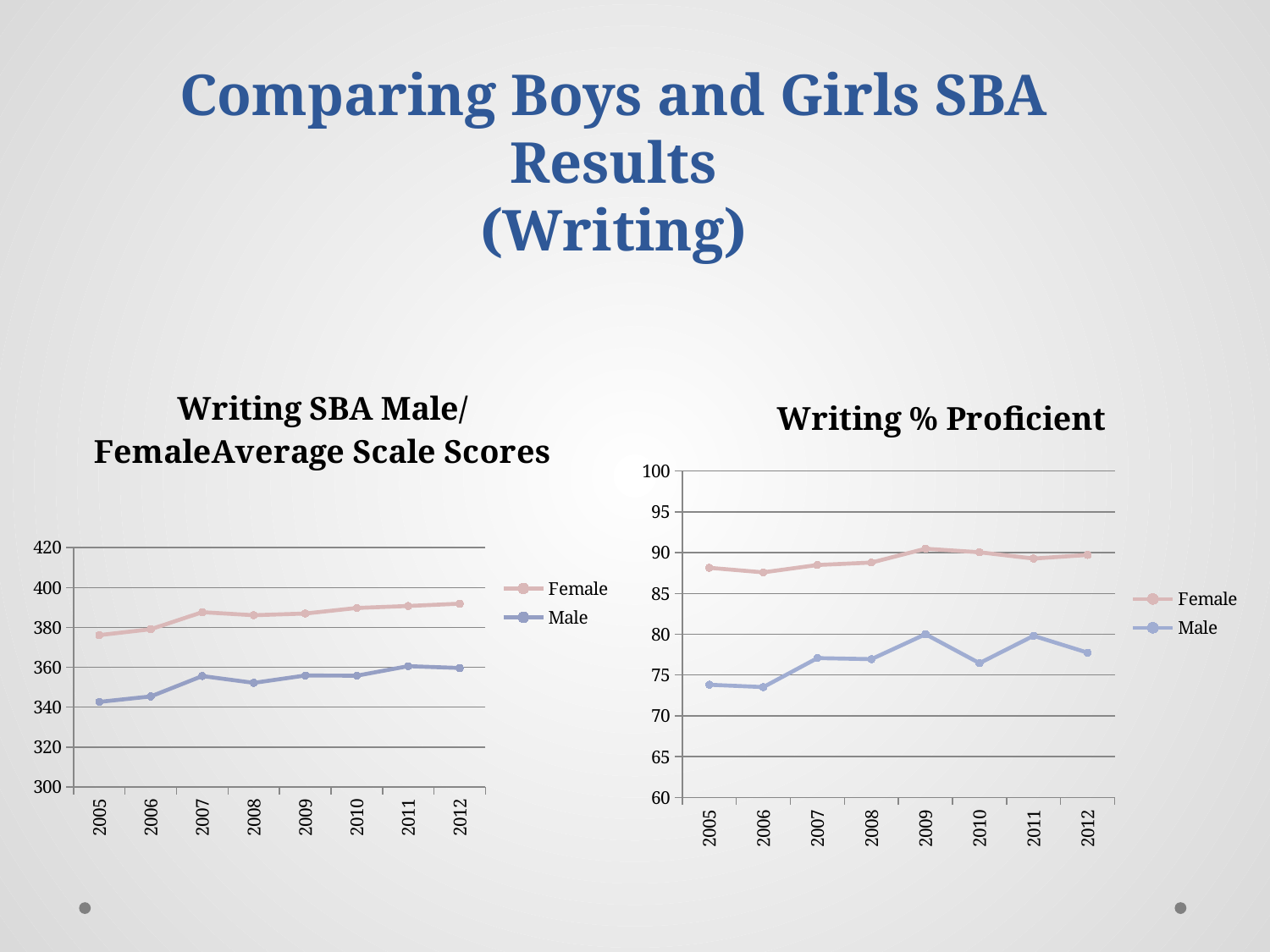
In the "Writing SBA Male/Female Average Scale Scores" chart, which year has the lowest Male value? 2005 In the "Writing SBA Male/Female Average Scale Scores" chart, which year has the highest Female value? 2012 In the "Writing SBA Male/Female Average Scale Scores" chart, is the Male value for 2007 greater or less than 360? less In the "Writing SBA Male/Female Average Scale Scores" chart, is the Female value for 2005 greater or less than 380? less What is the title of the chart on the right side of the slide? Writing % Proficient In the "Writing SBA Male/Female Average Scale Scores" chart, which series has the higher value in 2012, Female or Male? Female In the "Writing % Proficient" chart, is the Female value for 2005 greater or less than 85? greater How many years are shown on the x axis of the "Writing SBA Male/Female Average Scale Scores" chart? 8 How many series does the legend of the "Writing % Proficient" chart list? 2 In the "Writing % Proficient" chart, does the Female series generally rise or fall from 2005 to 2012? rise What kind of chart is the "Writing SBA Male/Female Average Scale Scores" chart on the left? line chart